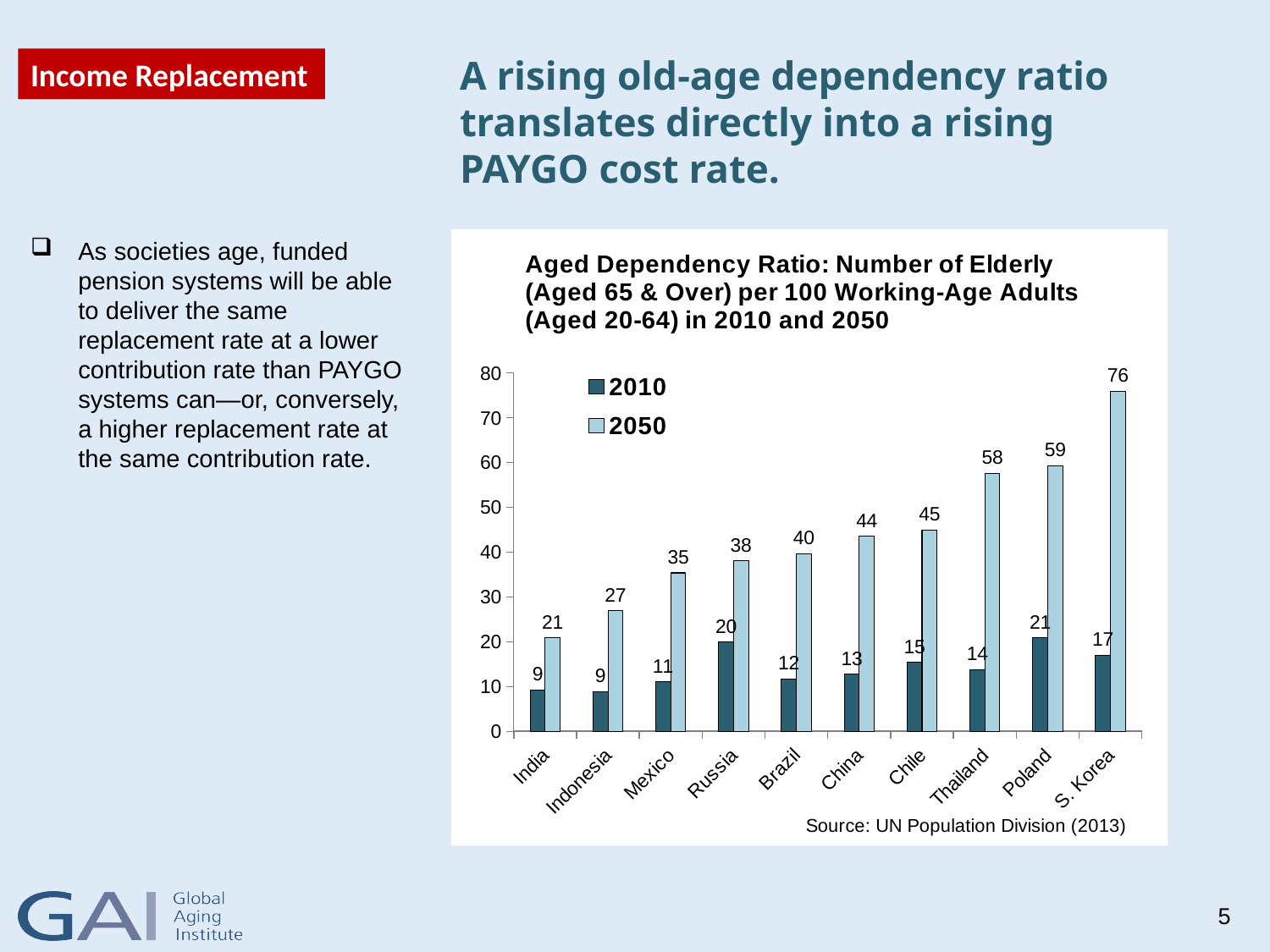
What is the source cited for the chart? UN Population Division (2013) What is the difference between the 2050 and 2010 aged dependency ratios for China? 31 How many countries are shown in the chart? 10 How many series does the legend list? 2 Which country has the lowest 2050 aged dependency ratio? India What kind of chart is shown on the slide? Bar chart What is the 2050 aged dependency ratio for Thailand? 58 Which country has the highest 2050 aged dependency ratio? S. Korea Which is larger, the 2050 aged dependency ratio for Poland or for Thailand? Poland What is the 2050 aged dependency ratio for S. Korea? 76 Is the 2050 aged dependency ratio for Mexico greater or less than 30? greater What is the 2010 aged dependency ratio for Russia? 20